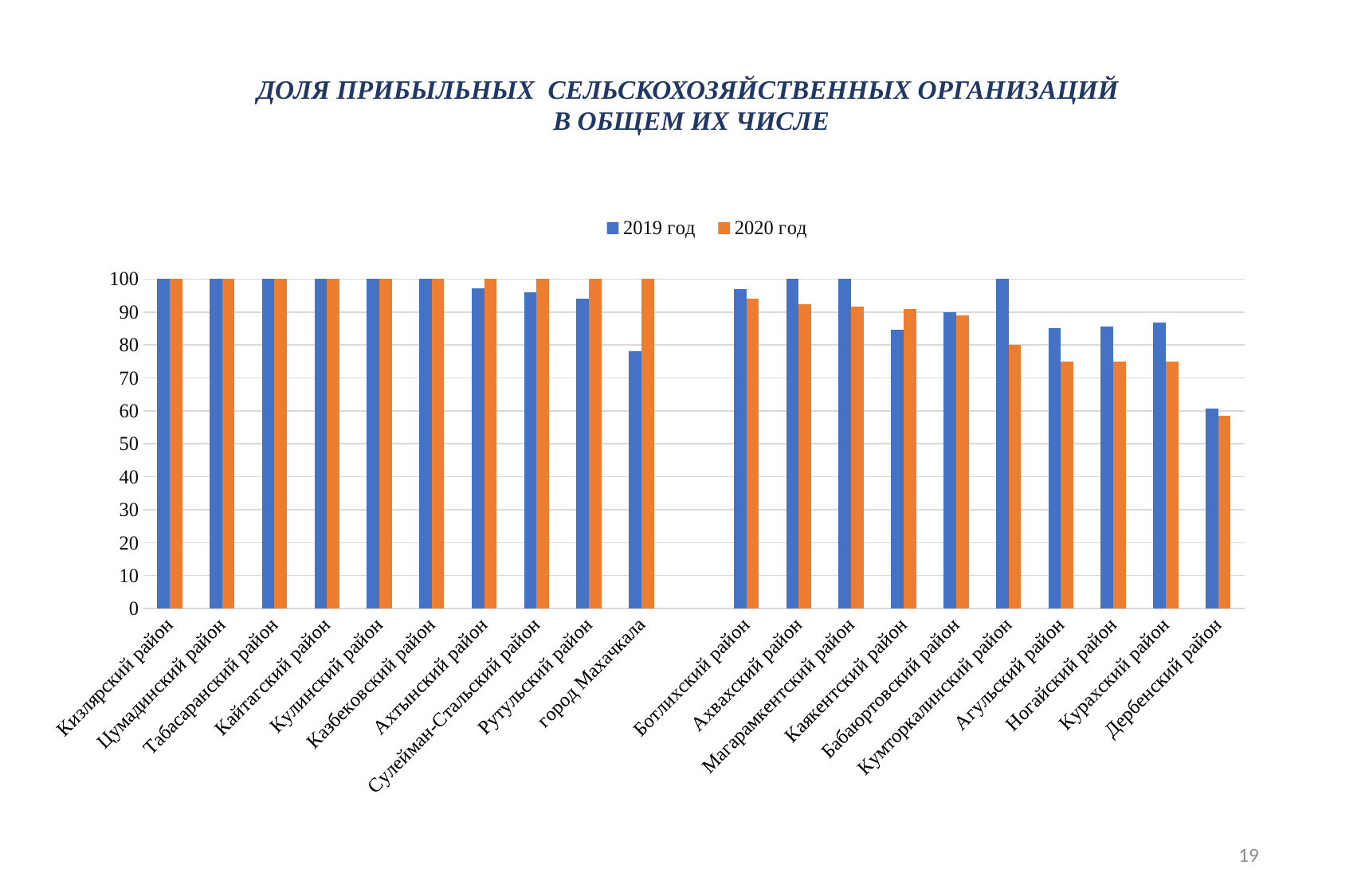
What are the two series named in the legend? 2019 год and 2020 год What is the value for Кумторкалинский район in 2019 год? 100 Is the value for Дербентский район in 2019 год greater or less than 70? less What is the value for город Махачкала in 2020 год? 100 Which district has the lowest value in 2019 год? Дербенский район Is the value for Агульский район in 2020 год greater or less than 80? less For Кумторкалинский район, which is larger: the 2019 год value or the 2020 год value? 2019 год What is the value for Кизлярский район in 2019 год? 100 Which district has the lowest value in 2020 год? Дербенский район How many series does the legend list? 2 Which colour represents the 2020 год series? orange What kind of chart is shown on the slide? bar chart